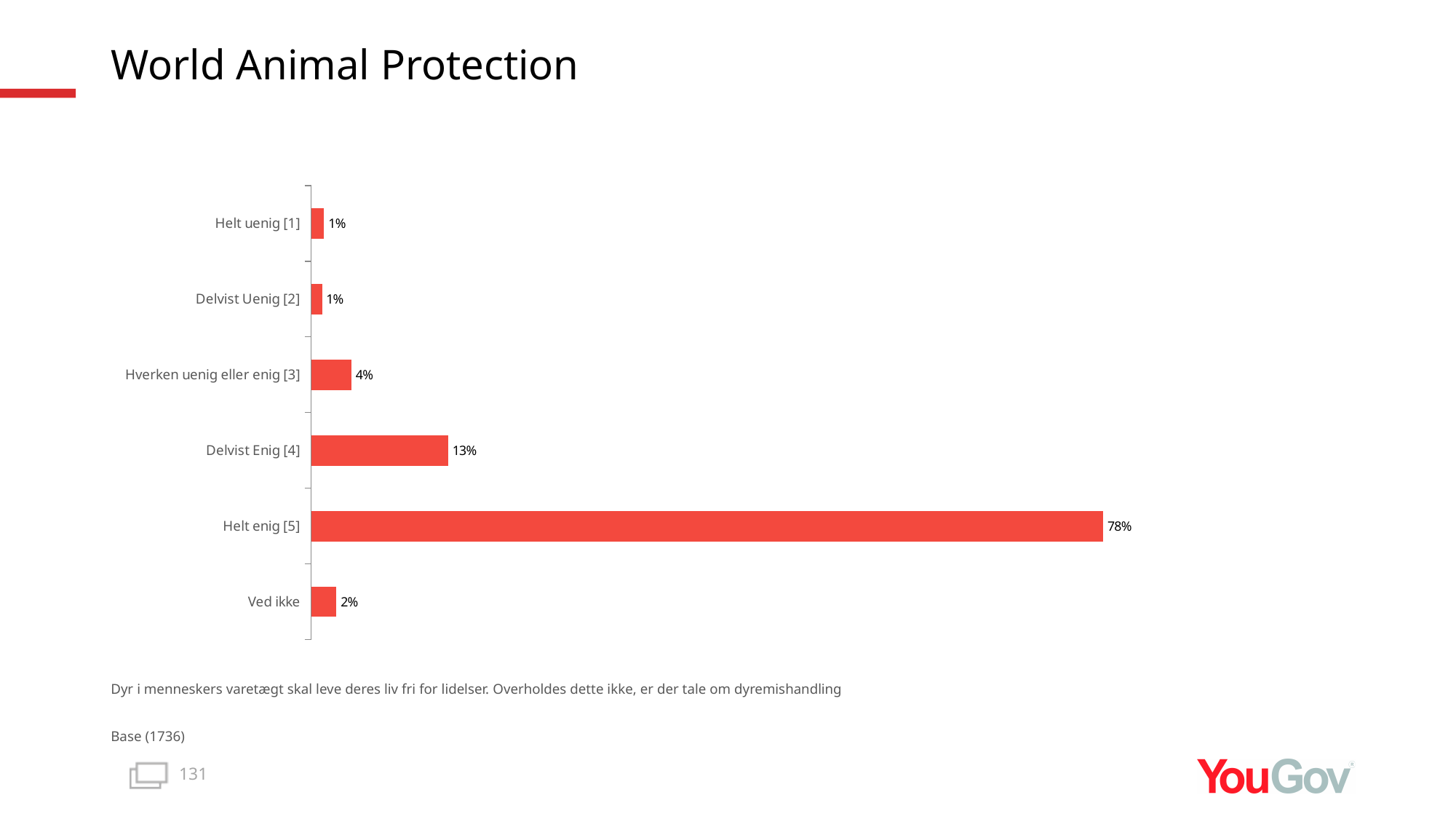
Which category has the highest value? Helt enig [5] Which is larger, "Delvist Enig [4]" or "Hverken uenig eller enig [3]"? Delvist Enig [4] What is the difference between "Hverken uenig eller enig [3]" and "Ved ikke"? 2% What is the title of the slide? World Animal Protection What is the value shown for "Delvist Enig [4]"? 13% What percentage is shown for "Hverken uenig eller enig [3]"? 4% What percentage of respondents answered "Helt enig [5]"? 78% What is the difference between "Helt enig [5]" and "Delvist Enig [4]"? 65% What type of chart is shown on the slide? Bar chart What is the value for "Ved ikke"? 2% How many categories are shown in the chart? 6 What is the base (number of respondents) stated on the slide? 1736